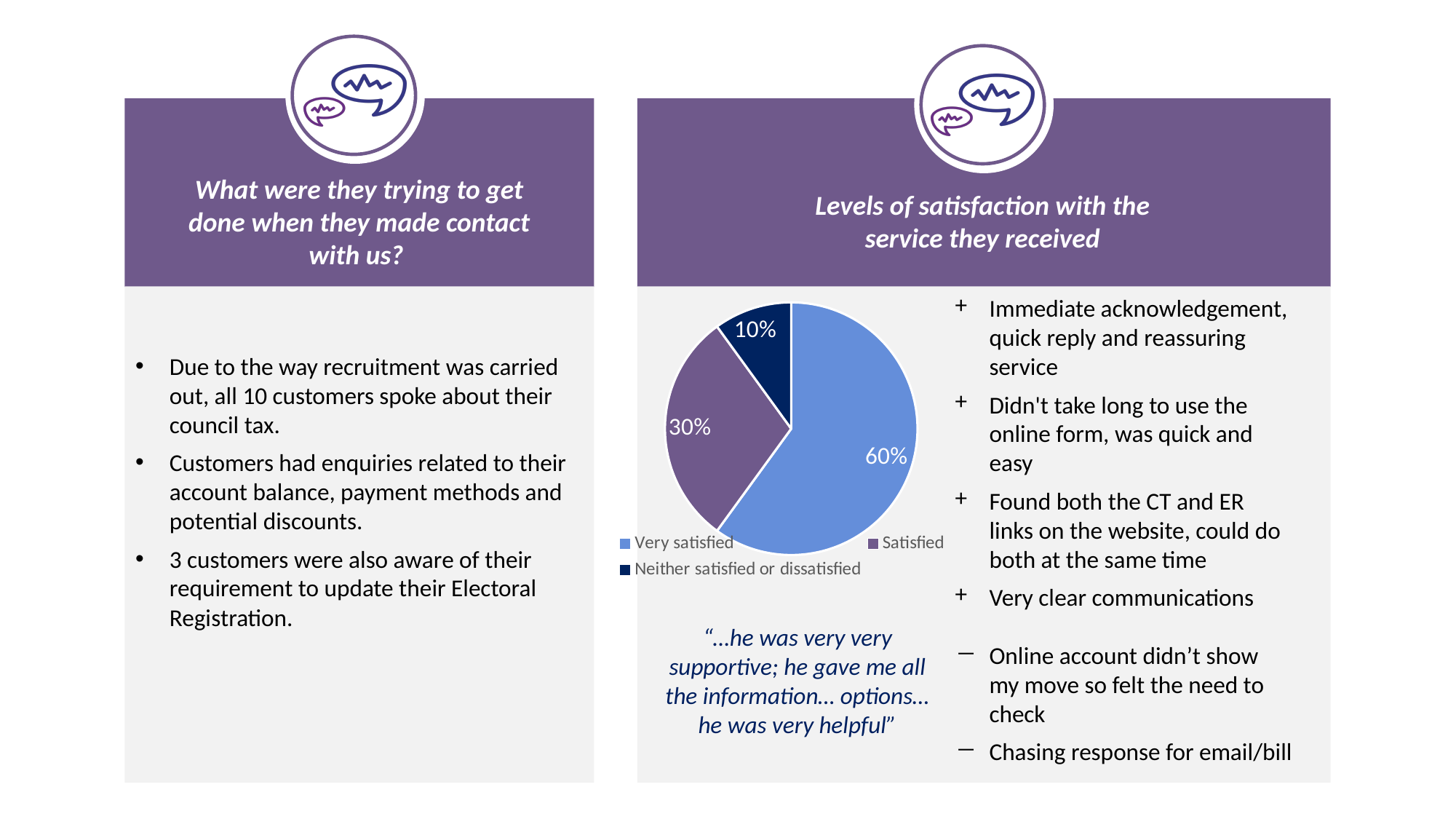
What share of the pie chart is 'Neither satisfied or dissatisfied'? 10% What is the difference in percentage points between 'Satisfied' and 'Neither satisfied or dissatisfied'? 20 Which category has the largest slice of the pie chart? Very satisfied What colour is the 'Neither satisfied or dissatisfied' slice? Dark navy blue What share of the pie chart is 'Satisfied'? 30% How many categories does the pie chart show? 3 Which category has the smallest slice of the pie chart? Neither satisfied or dissatisfied What kind of chart is shown on the slide? Pie chart What share of the pie chart is 'Very satisfied'? 60% Which is larger, the 'Satisfied' slice or the 'Neither satisfied or dissatisfied' slice? Satisfied What is the title above the pie chart? Levels of satisfaction with the service they received What is the difference in percentage points between 'Very satisfied' and 'Satisfied'? 30